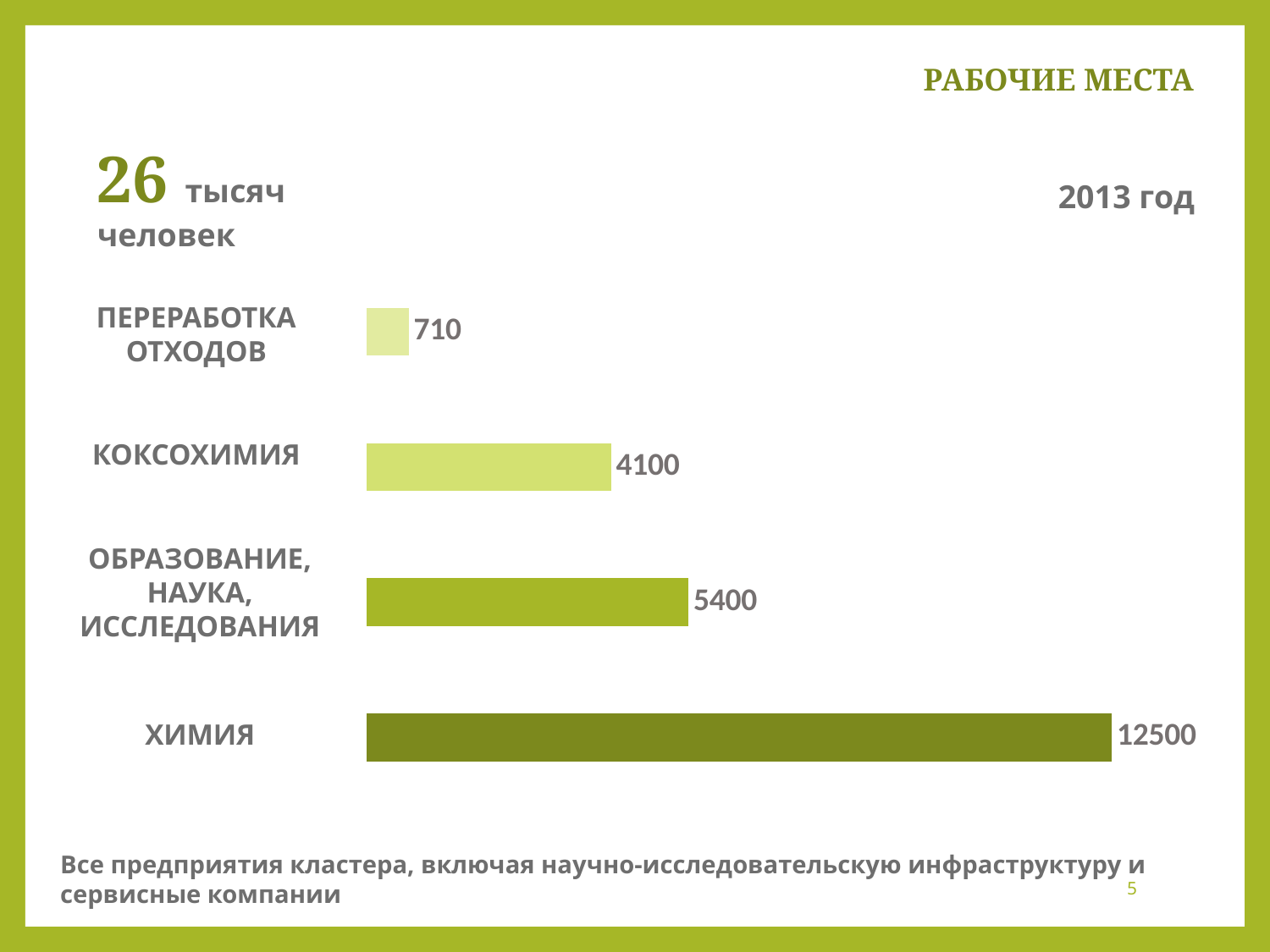
What is the difference between the values for КОКСОХИМИЯ and ПЕРЕРАБОТКА ОТХОДОВ? 3390 What is the value for ОБРАЗОВАНИЕ, НАУКА, ИССЛЕДОВАНИЯ? 5400 What kind of chart is shown on the slide? bar chart How many categories are shown in the chart? 4 What is the value for ХИМИЯ? 12500 Which category has the lowest value? ПЕРЕРАБОТКА ОТХОДОВ What is the difference between the values for ХИМИЯ and ОБРАЗОВАНИЕ, НАУКА, ИССЛЕДОВАНИЯ? 7100 What is the value for КОКСОХИМИЯ? 4100 Which is larger, the value for КОКСОХИМИЯ or the value for ОБРАЗОВАНИЕ, НАУКА, ИССЛЕДОВАНИЯ? ОБРАЗОВАНИЕ, НАУКА, ИССЛЕДОВАНИЯ What year does the chart refer to, according to the slide? 2013 год What is the value for ПЕРЕРАБОТКА ОТХОДОВ? 710 Which category has the highest value? ХИМИЯ